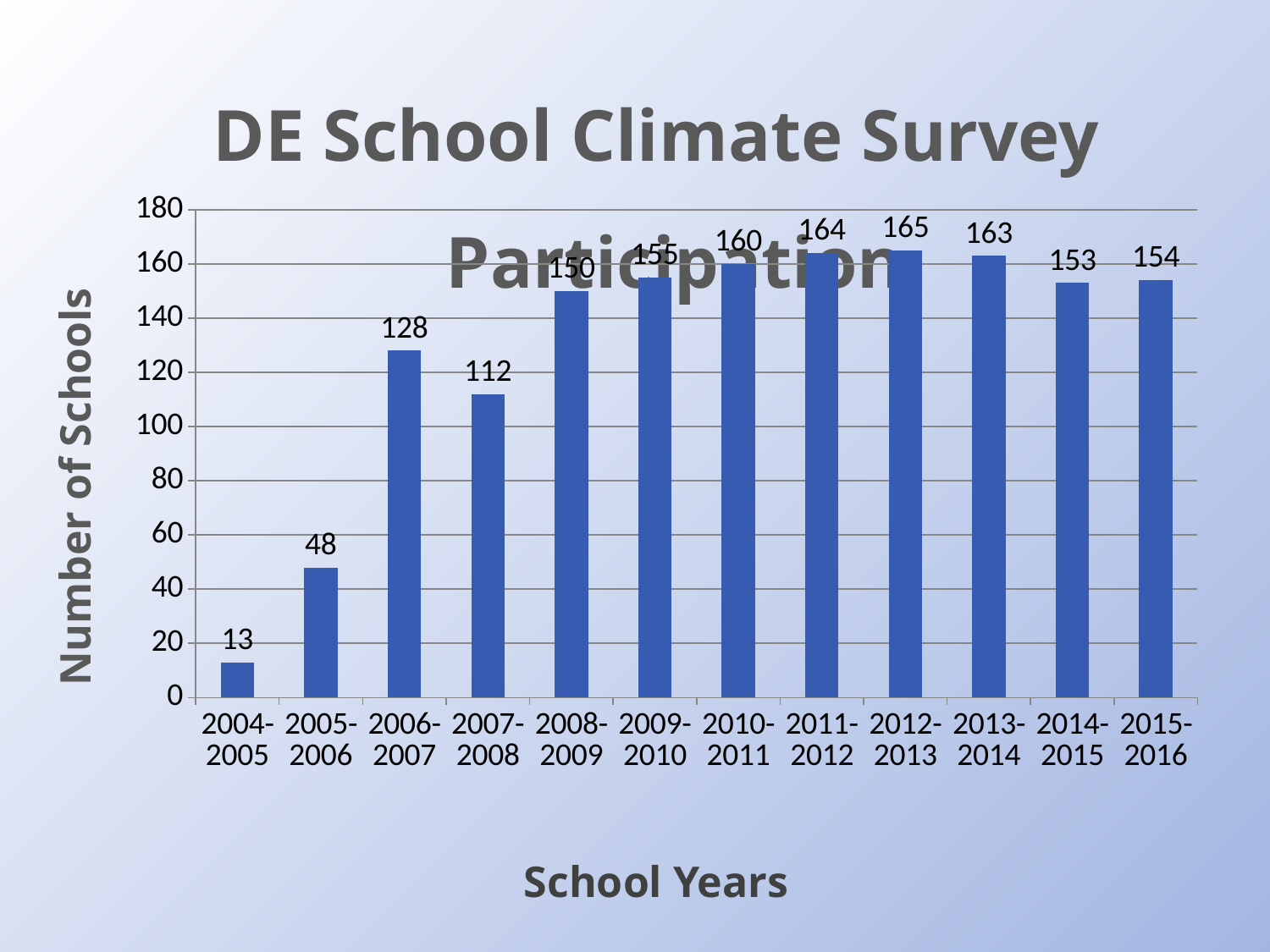
Is the value for 2008-2009 greater or less than 140? greater Which school year has the highest number of schools? 2012-2013 Which has more schools, 2006-2007 or 2007-2008? 2006-2007 What is the difference in number of schools between 2006-2007 and 2005-2006? 80 What is the difference in number of schools between 2012-2013 and 2014-2015? 12 What is the number of schools for 2004-2005? 13 What kind of chart is shown on the slide? Bar chart Which school year has the lowest number of schools? 2004-2005 How many school years are shown on the x axis? 12 What is the number of schools for 2007-2008? 112 What is the number of schools for 2015-2016? 154 What is the label of the y axis? Number of Schools